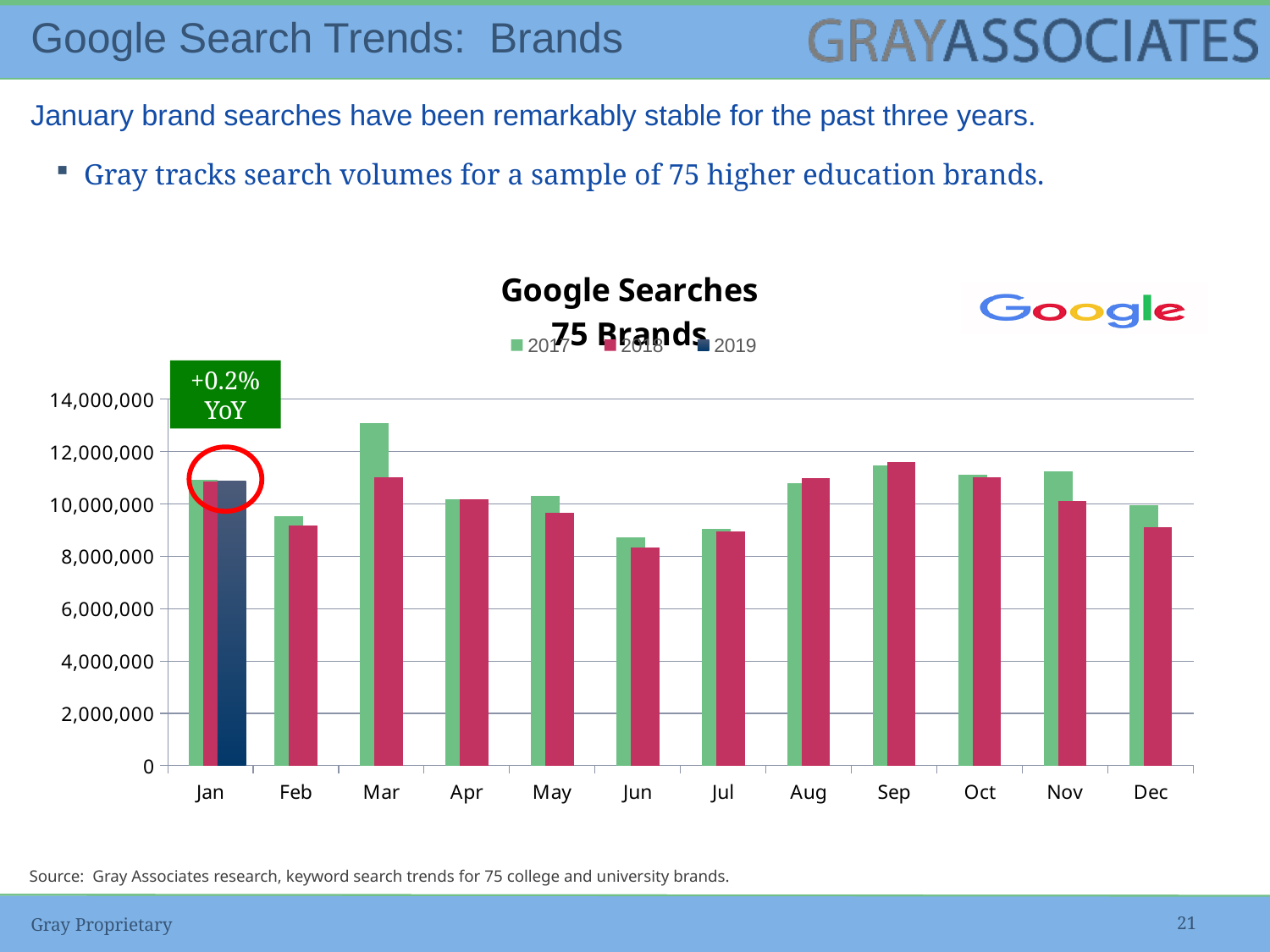
How many series does the legend of the Google Searches chart list? 3 Is the 2018 value for Jun greater or less than 10,000,000? less Which month has the highest 2017 value in the Google Searches chart? Mar How many months are shown along the x axis of the Google Searches chart? 12 What kind of chart is shown on the slide? Bar chart Is the 2018 value for Sep greater or less than 10,000,000? greater For Mar, which series has the larger value, 2017 or 2018? 2017 Which month has the highest 2018 value in the Google Searches chart? Sep Which month has the lowest 2018 value in the Google Searches chart? Jun What year-over-year change is shown in the annotation box above the Jan bars? +0.2% YoY Is the 2017 value for Mar greater or less than 12,000,000? greater For Nov, which series has the larger value, 2017 or 2018? 2017